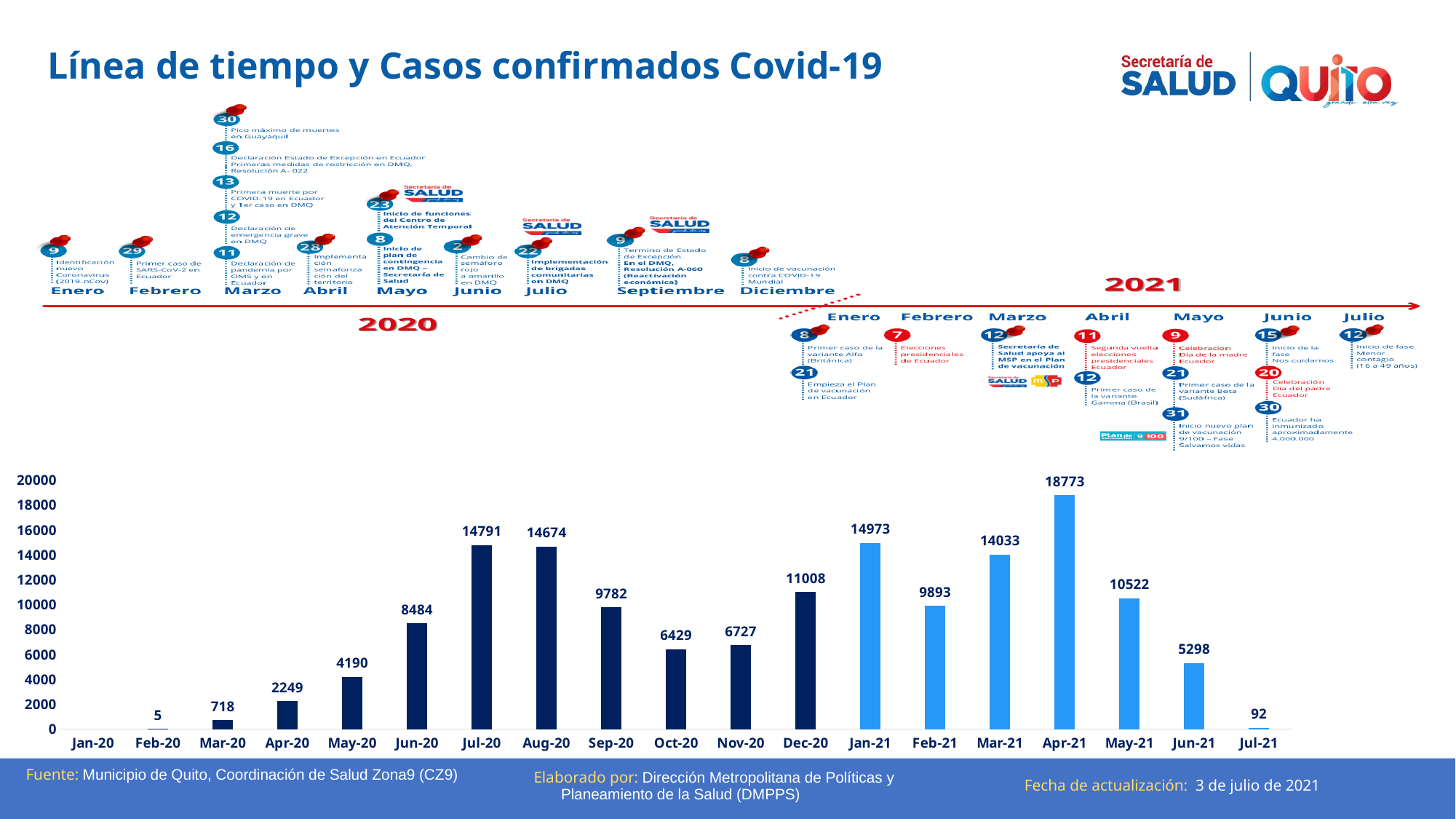
What is the value for Jun-21 in the bar chart? 5298 How many monthly categories are shown on the x axis of the bar chart? 19 What is the value for Dec-20 in the bar chart? 11008 Do the values rise or fall from Feb-20 to Jul-20? Rise What colour are the bars for the 2021 months in the bar chart? Light blue What is the difference between the values for Apr-21 and Jan-21? 3800 Do the values rise or fall from Apr-21 to Jul-21? Fall Which is larger, the value for Oct-20 or the value for Nov-20? Nov-20 What is the value for Jul-20 in the bar chart? 14791 What is the difference between the values for Jul-20 and Aug-20? 117 Which month has the highest value in the bar chart? Apr-21 What type of chart is shown at the bottom of the slide? Bar chart